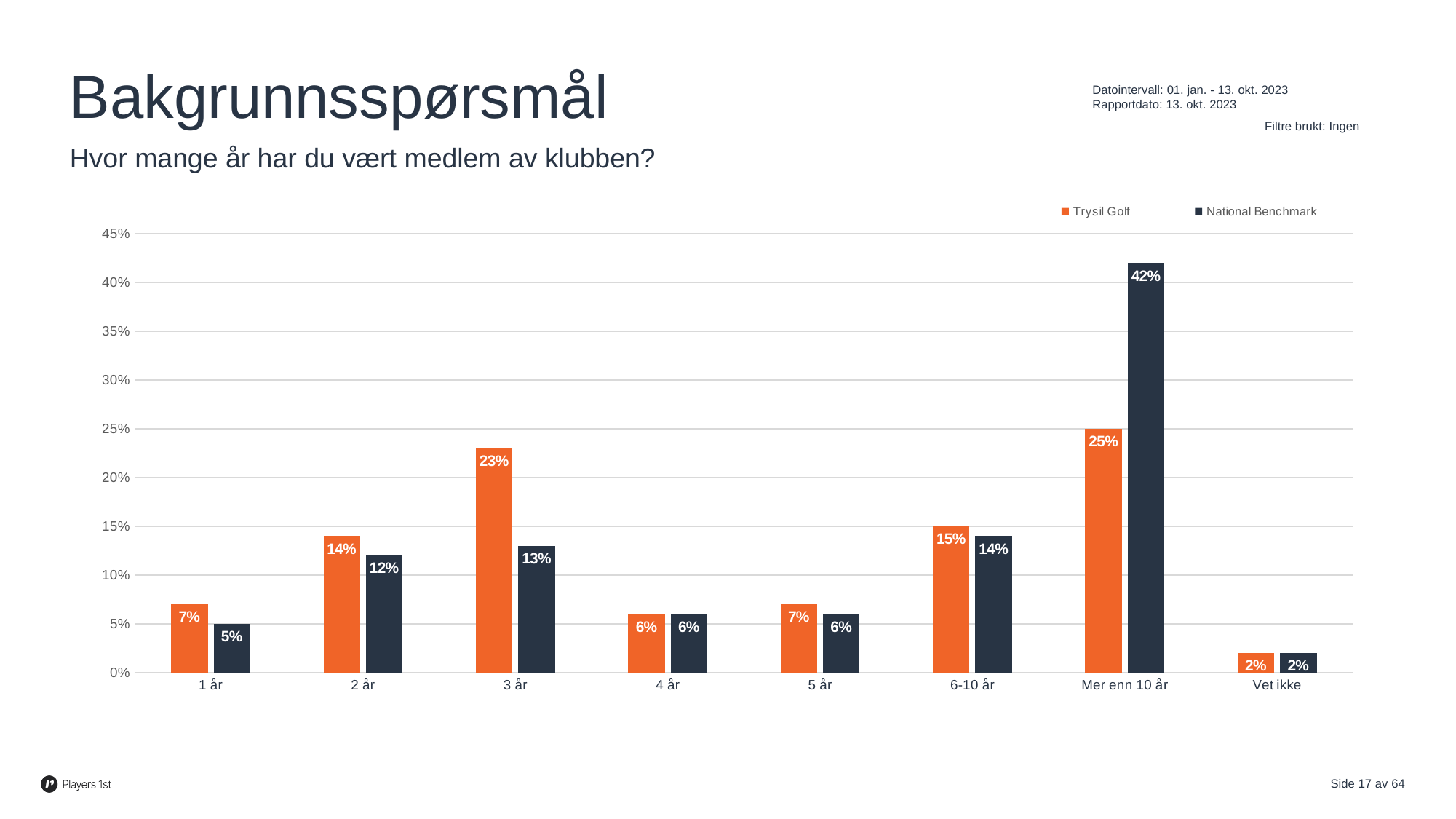
What is the Trysil Golf value for "6-10 år"? 15% Is the National Benchmark value for "Mer enn 10 år" greater or less than 40%? greater Which category has the lowest Trysil Golf value? Vet ikke For "3 år", which series has the larger value, Trysil Golf or National Benchmark? Trysil Golf How many series does the legend list? 2 What kind of chart is shown on the slide? Bar chart What is the National Benchmark value for "Mer enn 10 år"? 42% What question does the chart answer, according to the subtitle? Hvor mange år har du vært medlem av klubben? What is the Trysil Golf value for "3 år"? 23% What is the difference between the National Benchmark and Trysil Golf values for "Mer enn 10 år"? 17% How many categories are shown on the x axis? 8 Which category has the highest National Benchmark value? Mer enn 10 år